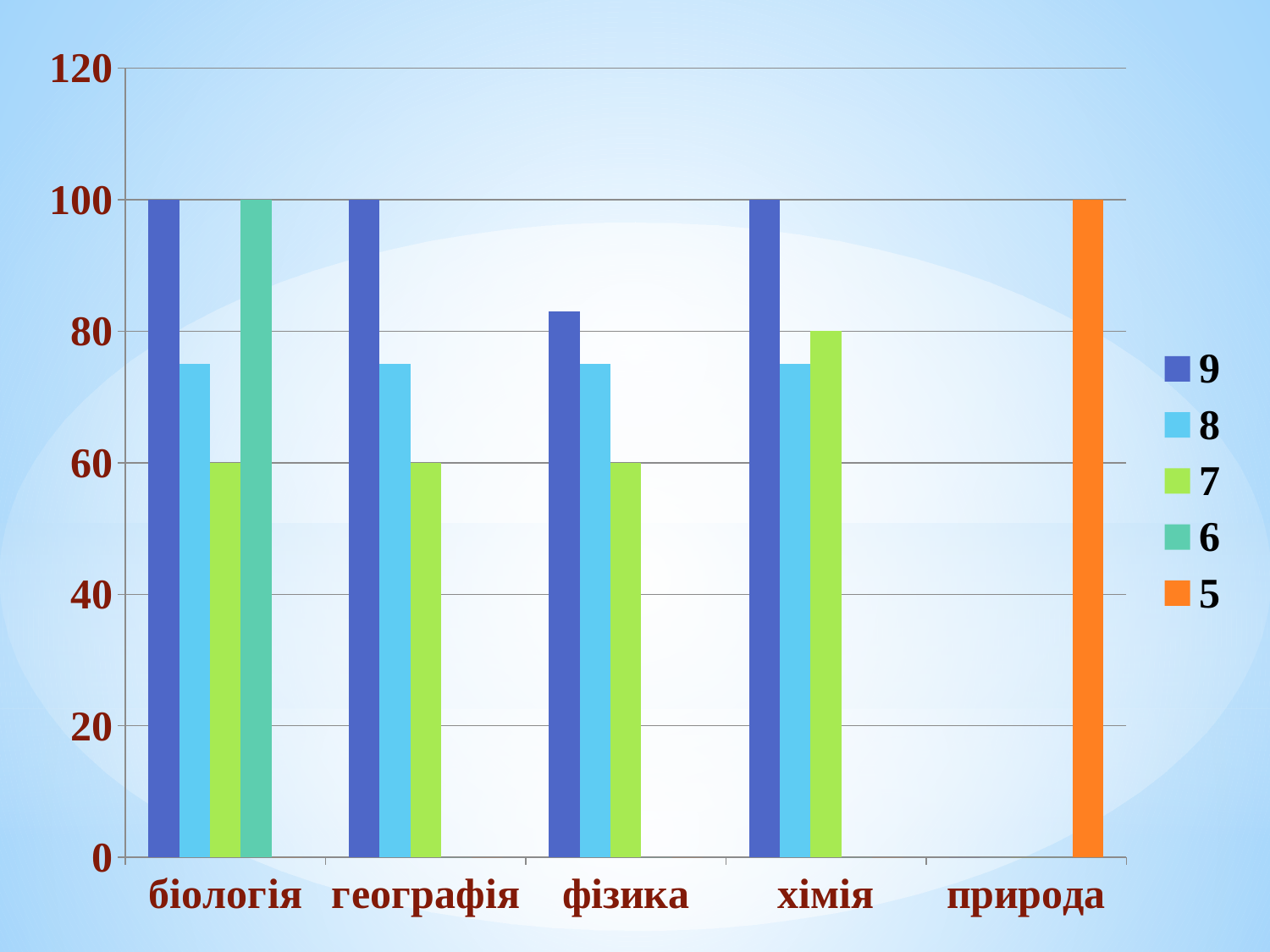
What is the value of series 7 for хімія? 80 What is the difference between series 9 and series 7 for географія? 40 What is the value of series 7 for географія? 60 Is the value of series 9 for фізика greater or less than 80? greater How many categories are shown on the x axis? 5 What is the value of series 9 for біологія? 100 Is the value of series 8 for фізика greater or less than 80? less For географія, which series has the larger value, 9 or 7? 9 What kind of chart is shown on the slide? bar chart How many series does the legend list? 5 What is the value of series 5 for природа? 100